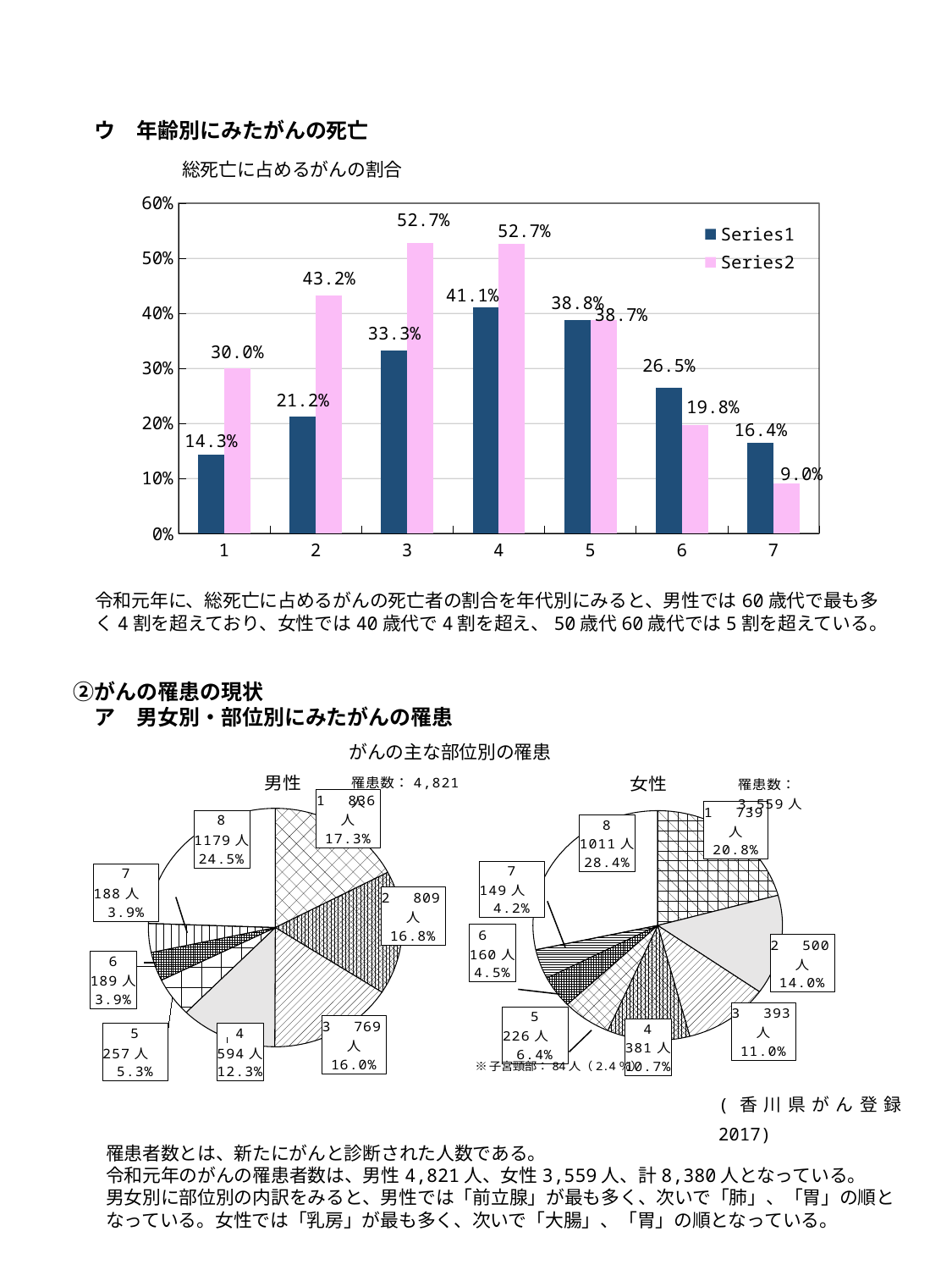
In the 女性 pie chart, which slice is the largest? 8 In the bar chart titled 総死亡に占めるがんの割合, which category has the highest Series1 value? 4 In the bar chart titled 総死亡に占めるがんの割合, which is larger for category 6, Series1 or Series2? Series1 In the 男性 pie chart, how many people are in slice 8? 1179人 What kind of chart is the chart titled 総死亡に占めるがんの割合? bar chart In the bar chart titled 総死亡に占めるがんの割合, how many categories are shown on the x axis? 7 In the 女性 pie chart, what share of the pie is slice 2? 14.0% In the bar chart titled 総死亡に占めるがんの割合, which category has the lowest Series2 value? 7 In the bar chart titled 総死亡に占めるがんの割合, what is the value of Series1 for category 4? 41.1% In the bar chart titled 総死亡に占めるがんの割合, what is the value of Series2 for category 2? 43.2% In the bar chart titled 総死亡に占めるがんの割合, what is the difference between Series2 and Series1 for category 1? 15.7% In the bar chart titled 総死亡に占めるがんの割合, how many series does the legend list? 2